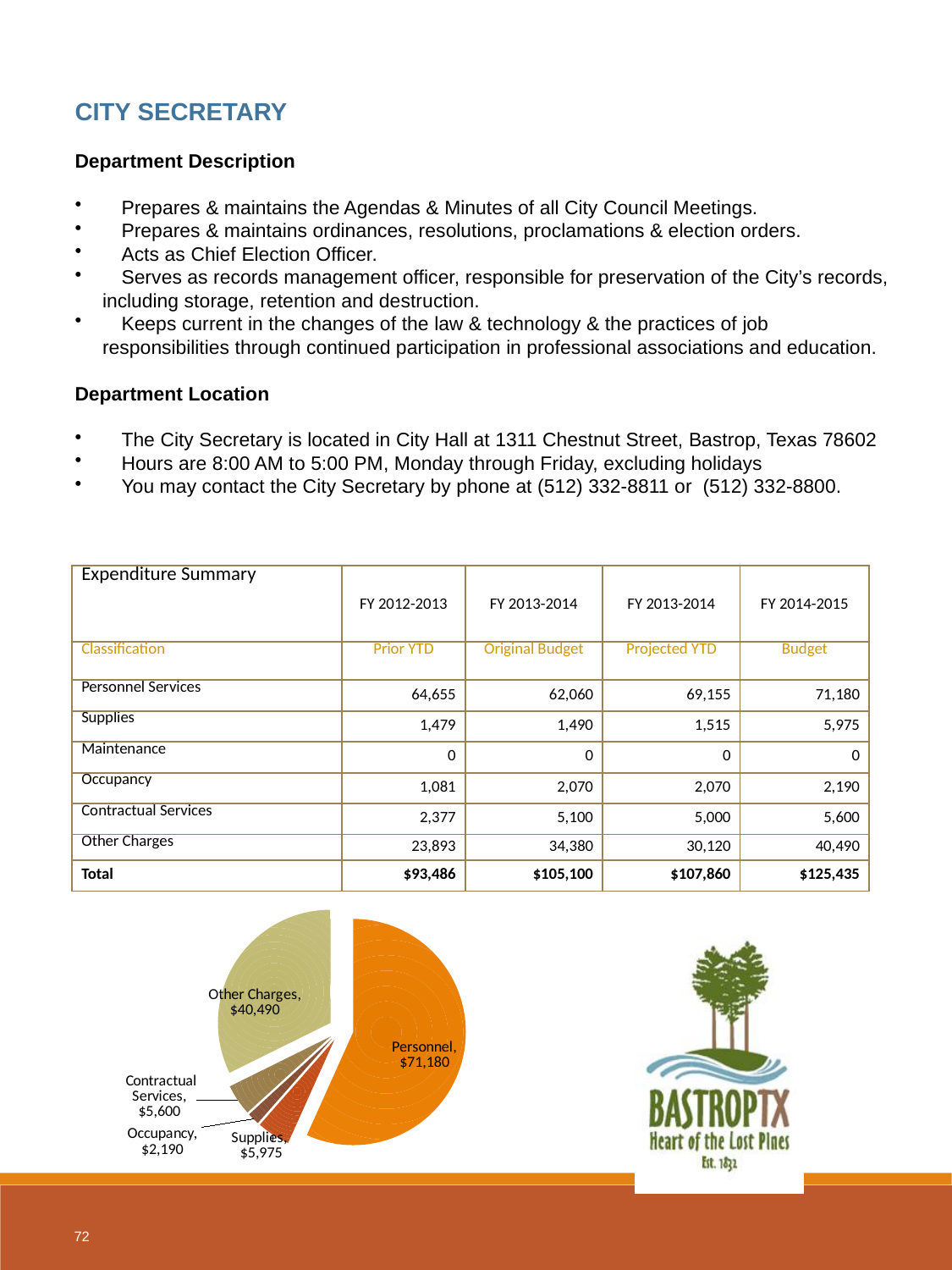
How many slices does the pie chart have? 5 What is the value shown for Personnel in the pie chart? $71,180 Which is larger in the pie chart, Supplies or Contractual Services? Supplies Which category has the smallest slice in the pie chart? Occupancy What kind of chart is shown on the slide? Pie chart What is the value shown for Supplies in the pie chart? $5,975 What is the difference between the Supplies and Contractual Services values in the pie chart? $375 What is the total of all the slice values in the pie chart? $125,435 Which category has the largest slice in the pie chart? Personnel What is the value shown for Other Charges in the pie chart? $40,490 What is the value shown for Occupancy in the pie chart? $2,190 What is the difference between the Personnel and Other Charges values in the pie chart? $30,690